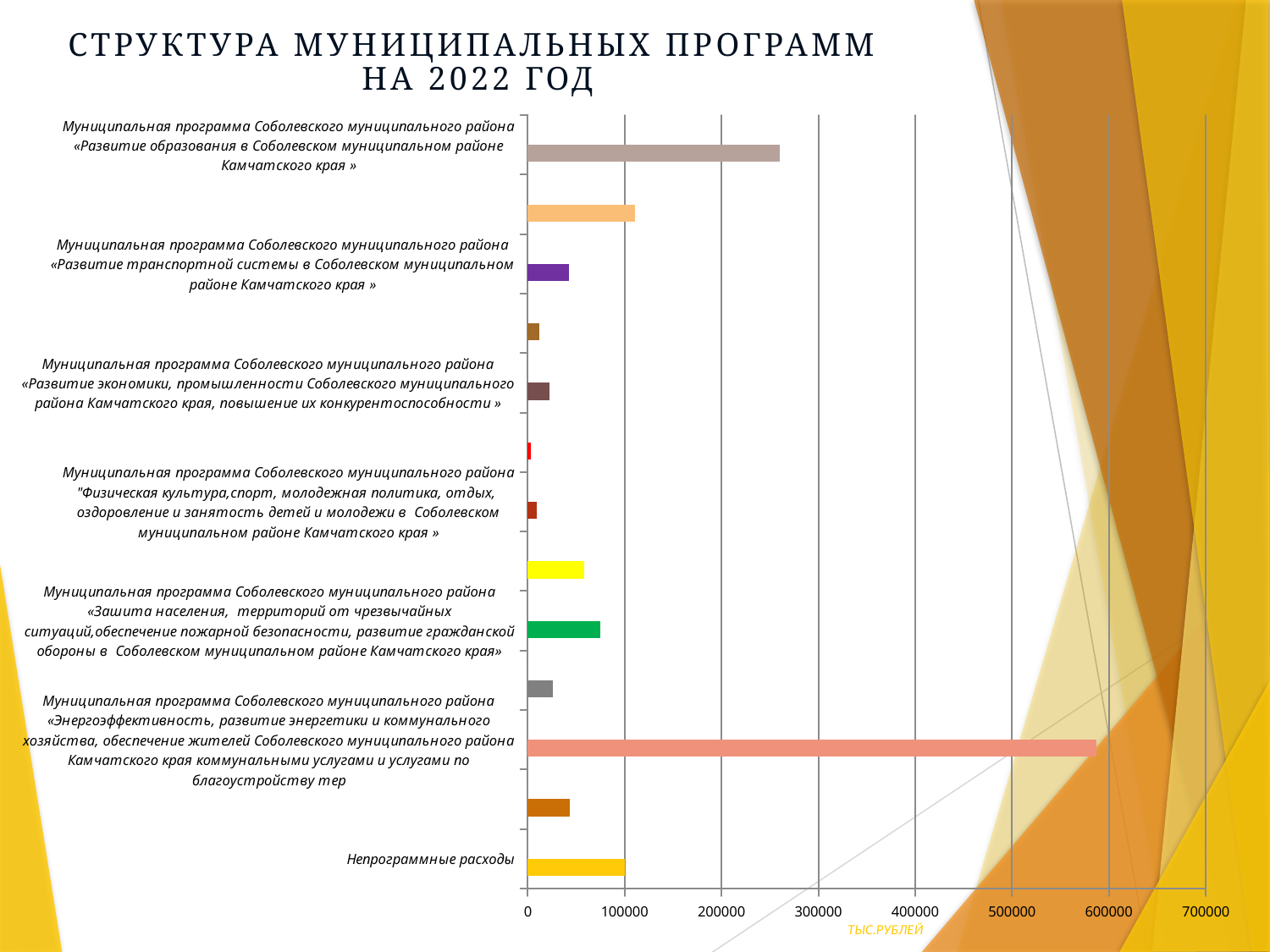
What is the highest value shown on the horizontal axis of the chart? 700000 What unit is shown under the horizontal axis of the chart? ТЫС.РУБЛЕЙ What is the title of the slide's chart? СТРУКТУРА МУНИЦИПАЛЬНЫХ ПРОГРАММ НА 2022 ГОД What kind of chart is shown on the slide? bar chart Is the value for the programme «Развитие образования в Соболевском муниципальном районе Камчатского края» greater or less than 200000? greater Which is larger: the value for «Развитие образования в Соболевском муниципальном районе Камчатского края» or the value for «Непрограммные расходы»? Развитие образования в Соболевском муниципальном районе Камчатского края Is the value for «Непрограммные расходы» greater or less than 50000? greater How many bars are plotted in the chart? 13 Is the value for the programme «Развитие образования в Соболевском муниципальном районе Камчатского края» greater or less than 300000? less